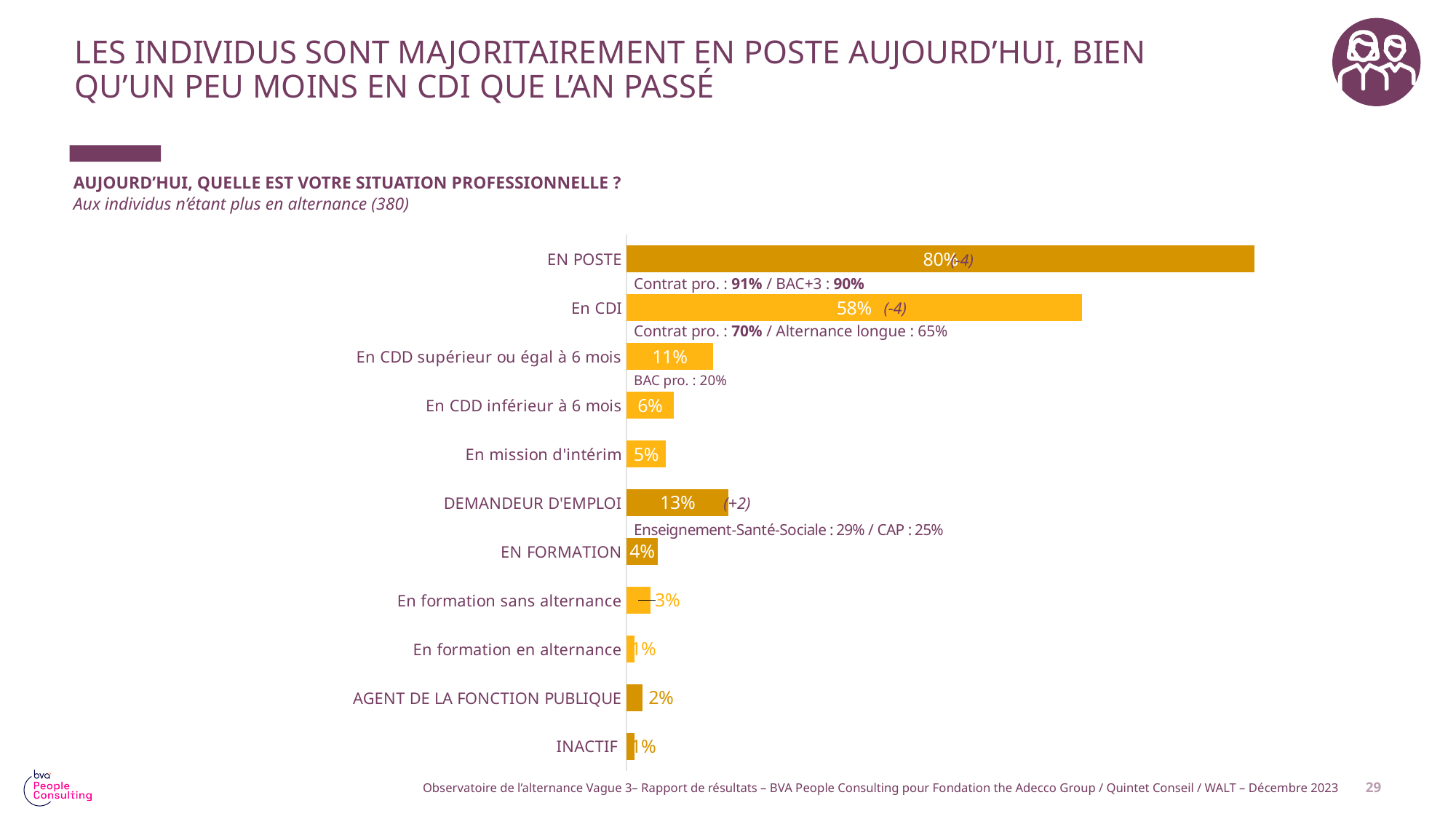
What is the value for En CDI? 58% Which category has the highest value? EN POSTE Which is larger, the value for DEMANDEUR D'EMPLOI or the value for En CDD supérieur ou égal à 6 mois? DEMANDEUR D'EMPLOI How many categories are shown in the chart? 11 What is the value for En mission d'intérim? 5% What is the value for En CDD supérieur ou égal à 6 mois? 11% What is the difference between the values for EN POSTE and En CDI? 22 points What kind of chart is shown on the slide? Bar chart What is the value for EN POSTE? 80% What is the value for DEMANDEUR D'EMPLOI? 13% What is the value for AGENT DE LA FONCTION PUBLIQUE? 2% What change from the previous year is shown next to the En CDI bar? (-4)